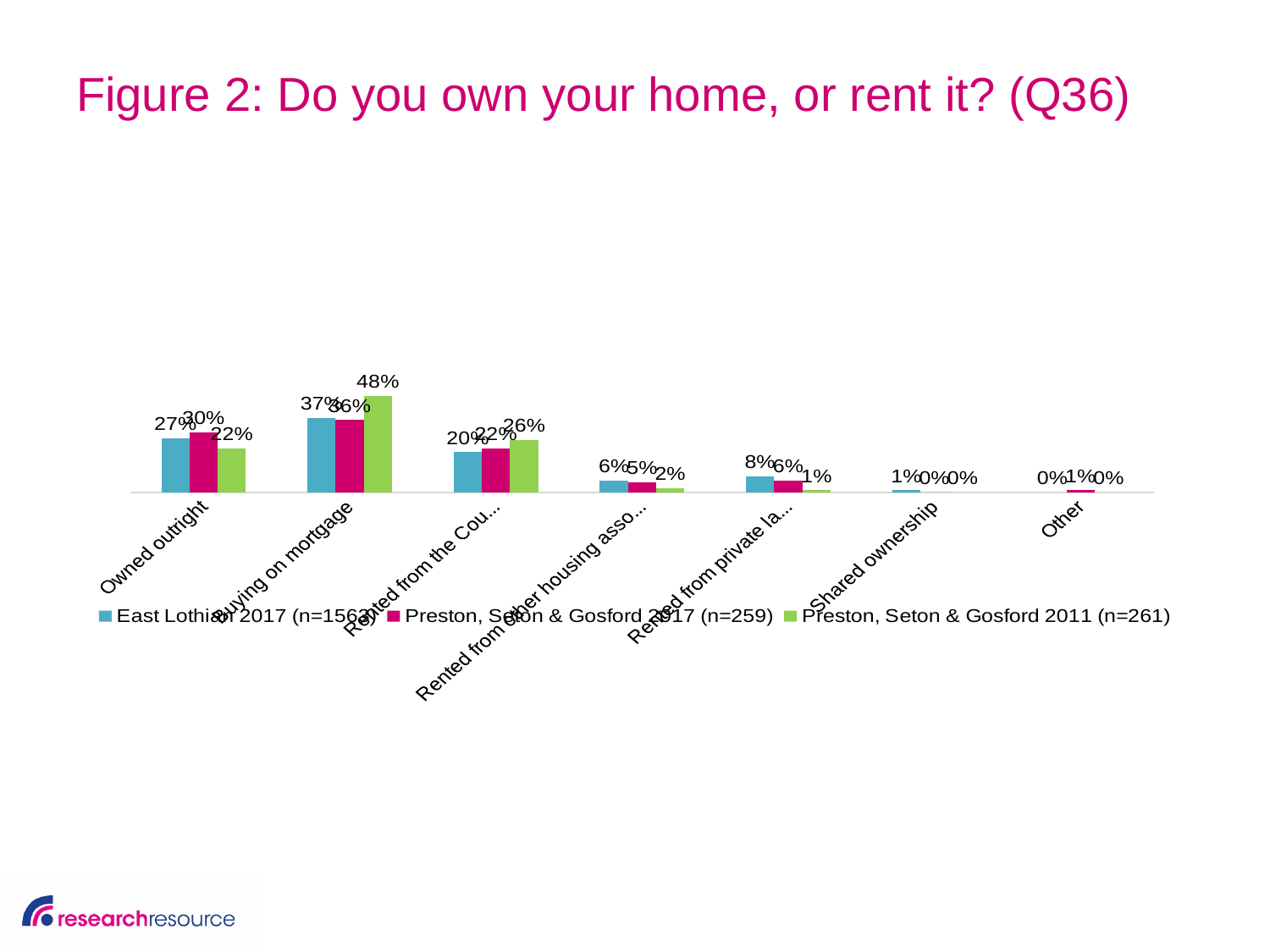
What is the value for East Lothian 2017 (n=1563) in the Buying on mortgage category? 37% What is the difference between the Preston, Seton & Gosford 2011 (n=261) and East Lothian 2017 (n=1563) values in the Buying on mortgage category? 11% What is the value for Preston, Seton & Gosford 2017 (n=259) in the Other category? 1% How many categories are shown on the x axis? 7 In the Owned outright category, which is larger: the East Lothian 2017 (n=1563) value or the Preston, Seton & Gosford 2011 (n=261) value? East Lothian 2017 (n=1563) What is the value for East Lothian 2017 (n=1563) in the Owned outright category? 27% How many series does the legend list? 3 What is the value for Preston, Seton & Gosford 2011 (n=261) in the Buying on mortgage category? 48% Which category has the highest value for Preston, Seton & Gosford 2011 (n=261)? Buying on mortgage What is the value for Preston, Seton & Gosford 2017 (n=259) in the Owned outright category? 30% What is the title of the chart? Figure 2: Do you own your home, or rent it? (Q36) What type of chart is shown on the slide? Bar chart